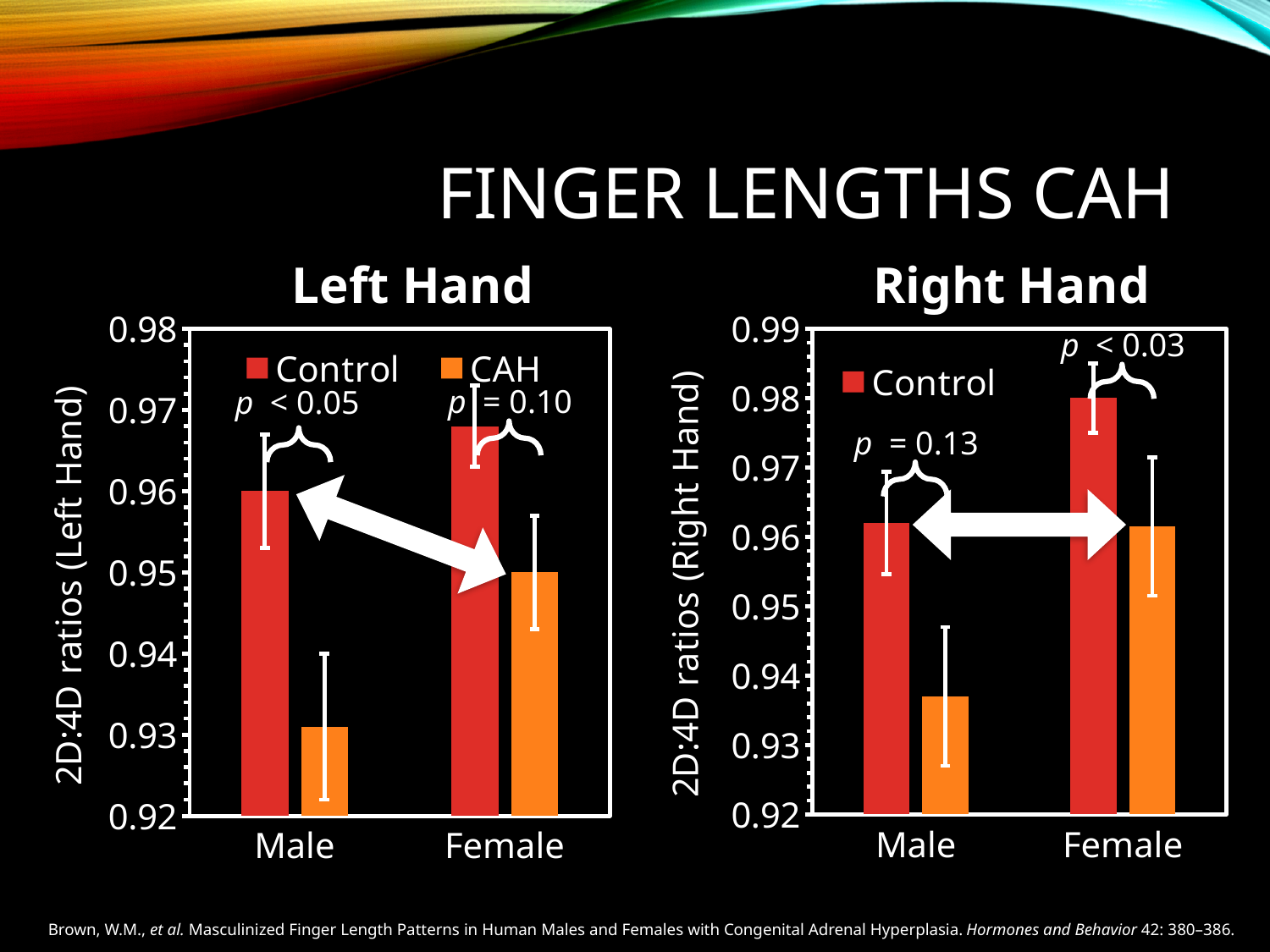
What kind of chart is the Left Hand chart? bar chart What is the y-axis title of the Right Hand chart? 2D:4D ratios (Right Hand) In the Left Hand chart, which is larger for Female: Control or CAH? Control In the Left Hand chart, which bar is the highest? Control, Female In the Right Hand chart, is the CAH value for Male greater or less than 0.94? less In the Left Hand chart, is the CAH value for Male greater or less than 0.94? less In the Left Hand chart, which bar is the lowest? CAH, Male In the Right Hand chart, is the Control value for Female greater or less than 0.97? greater In the Right Hand chart, which bar is the lowest? CAH, Male In the Left Hand chart, how many series does the legend list? 2 In the Left Hand chart, how many categories are shown on the x axis? 2